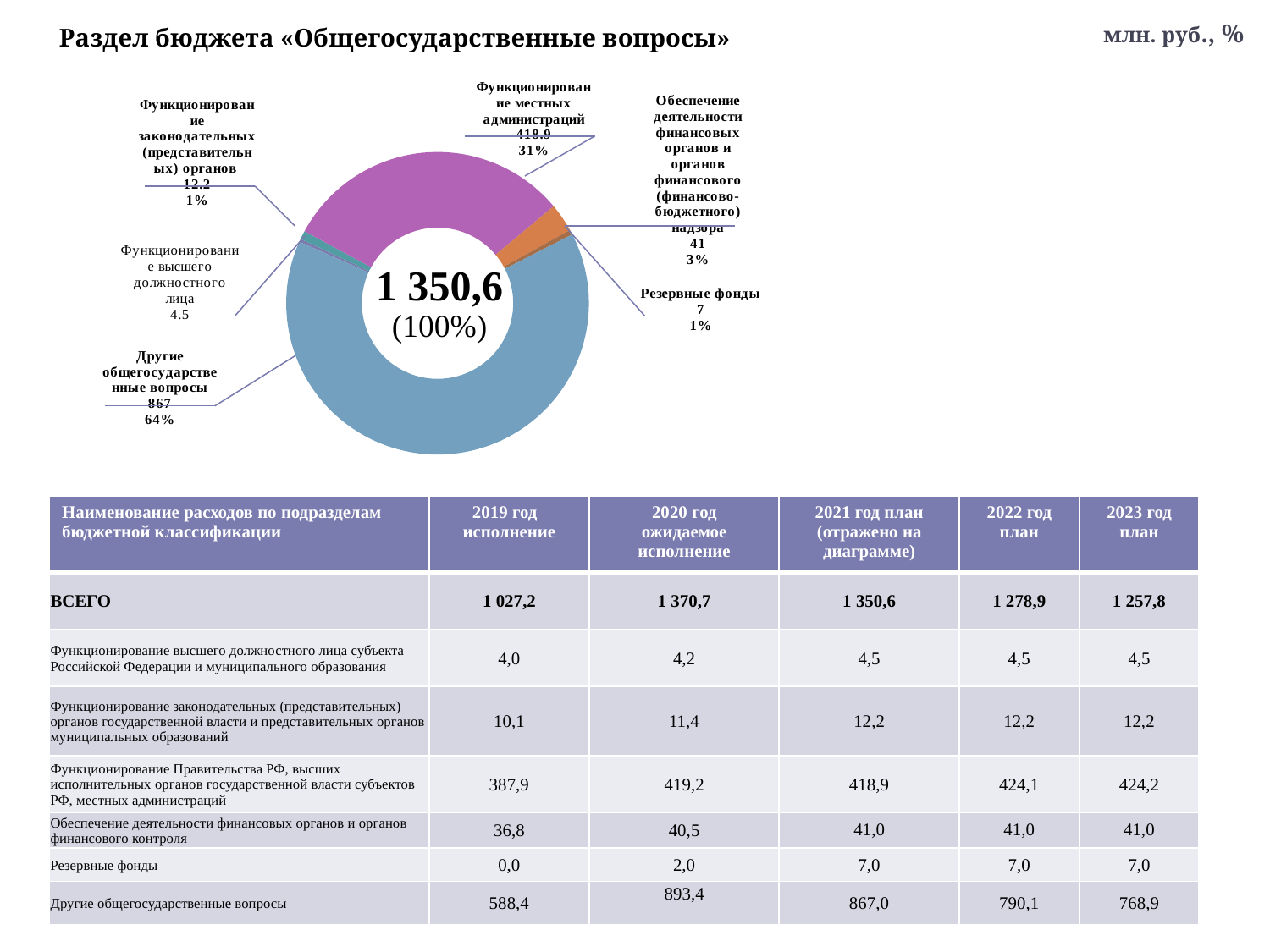
What value is shown for "Обеспечение деятельности финансовых органов и органов финансового (финансово-бюджетного) надзора" on the doughnut chart? 41 What value is shown for "Резервные фонды" on the doughnut chart? 7 What percentage is shown for "Функционирование местных администраций" on the doughnut chart? 31% What is the difference between the values for "Другие общегосударственные вопросы" and "Функционирование местных администраций" on the doughnut chart? 448.1 Which category has the largest slice of the doughnut chart? Другие общегосударственные вопросы What share of the doughnut chart does "Другие общегосударственные вопросы" represent? 64% What is the total value shown in the centre of the doughnut chart? 1 350,6 How many categories are shown on the doughnut chart? 6 What value is shown for "Функционирование местных администраций" on the doughnut chart? 418.9 What value is shown for "Другие общегосударственные вопросы" on the doughnut chart? 867 Which is larger on the doughnut chart: "Функционирование местных администраций" or "Обеспечение деятельности финансовых органов"? Функционирование местных администраций What type of chart is shown on the slide? Doughnut chart